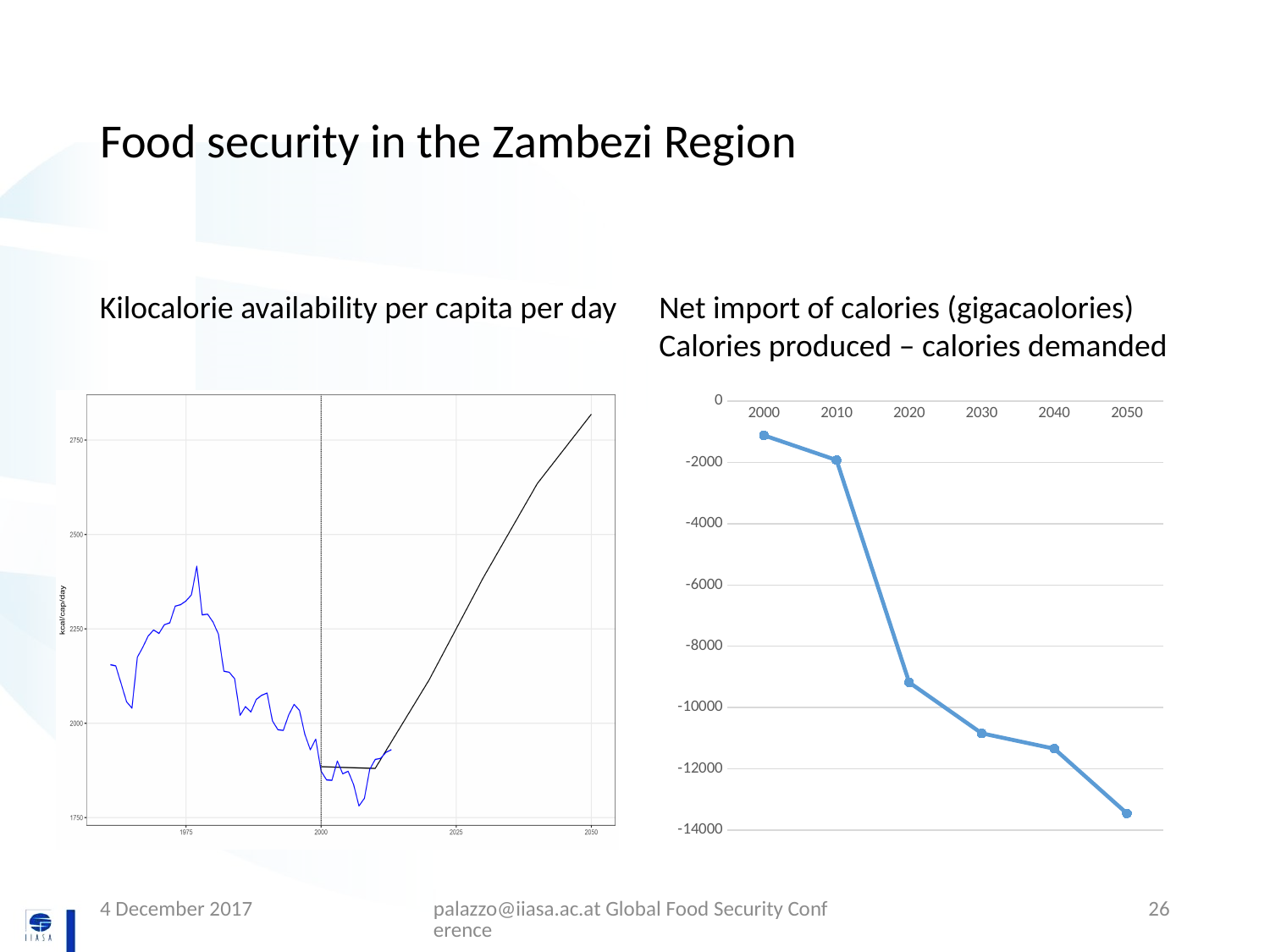
What kind of chart is the right-hand chart, 'Net import of calories (gigacaolories)'? line chart What kind of chart is the left-hand chart, 'Kilocalorie availability per capita per day'? line chart In the right-hand chart 'Net import of calories', do the values rise or fall from 2000 to 2050? fall In the right-hand chart 'Net import of calories', which year has the lowest (most negative) value? 2050 What is the y-axis label of the left-hand chart 'Kilocalorie availability per capita per day'? kcal/cap/day In the right-hand chart 'Net import of calories', is the value for 2010 greater or less than -4000? greater In the right-hand chart 'Net import of calories', how many data points are plotted? 6 In the right-hand chart 'Net import of calories', is the value for 2050 greater or less than -12000? less In the right-hand chart 'Net import of calories', is the value for 2020 greater or less than -8000? less In the right-hand chart 'Net import of calories', which is larger, the value for 2010 or the value for 2030? 2010 In the right-hand chart 'Net import of calories', which year has the highest (least negative) value? 2000